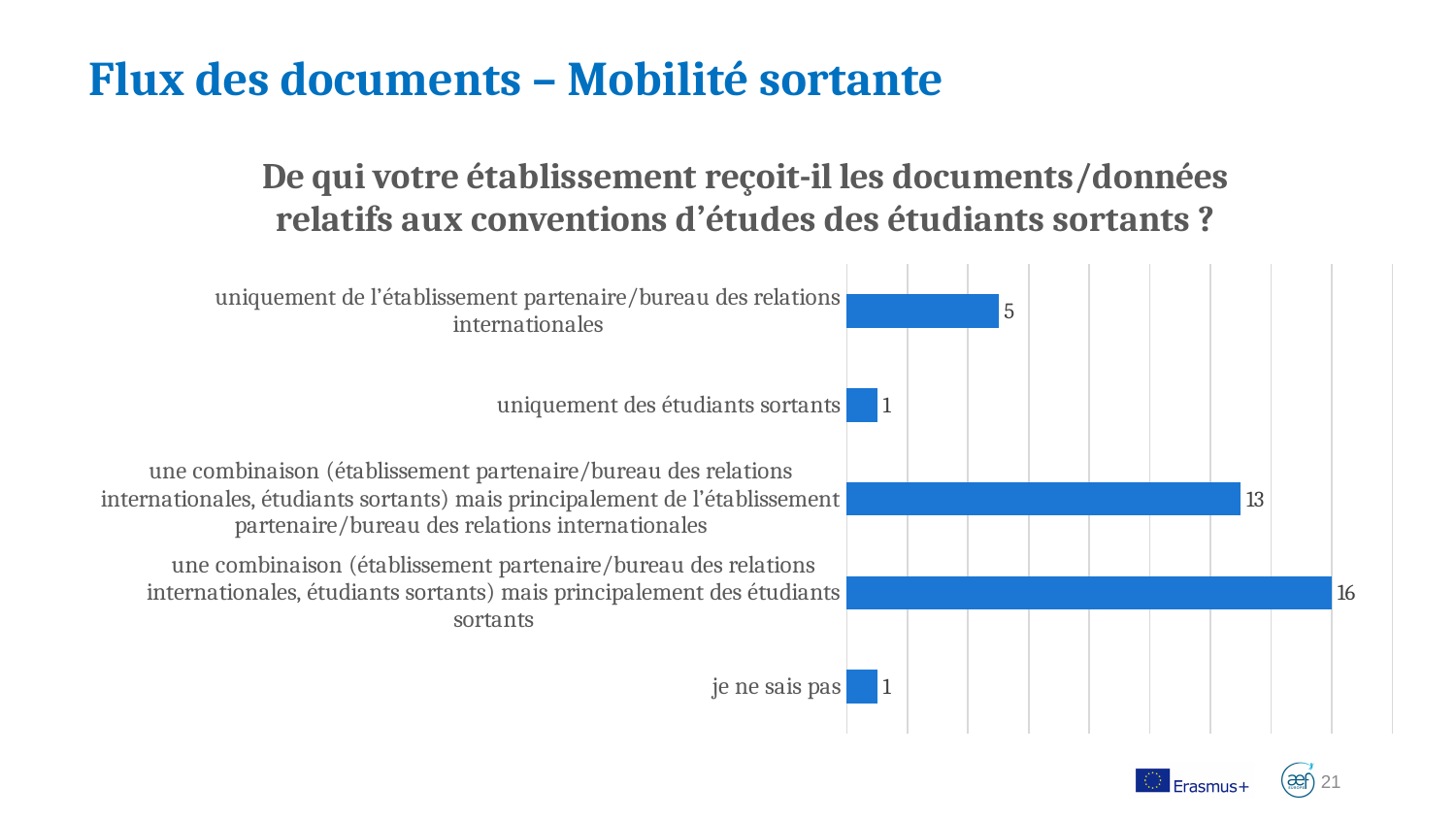
What question does the chart title ask? De qui votre établissement reçoit-il les documents/données relatifs aux conventions d'études des étudiants sortants ? What is the value for the combination option that is mainly from outgoing students? 16 Which is larger: the value for "uniquement de l'établissement partenaire/bureau des relations internationales" or the value for "uniquement des étudiants sortants"? uniquement de l'établissement partenaire/bureau des relations internationales What is the value for "uniquement de l'établissement partenaire/bureau des relations internationales"? 5 What is the difference between the two combination options (mainly outgoing students vs mainly partner institution)? 3 What is the difference between the value for "uniquement de l'établissement partenaire/bureau des relations internationales" and the value for "je ne sais pas"? 4 What kind of chart is shown on the slide? bar chart What is the value for "je ne sais pas"? 1 How many categories are shown in the chart? 5 What is the value for the combination option that is mainly from the partner institution/international relations office? 13 What is the value for "uniquement des étudiants sortants"? 1 Which category has the highest value? une combinaison (établissement partenaire/bureau des relations internationales, étudiants sortants) mais principalement des étudiants sortants